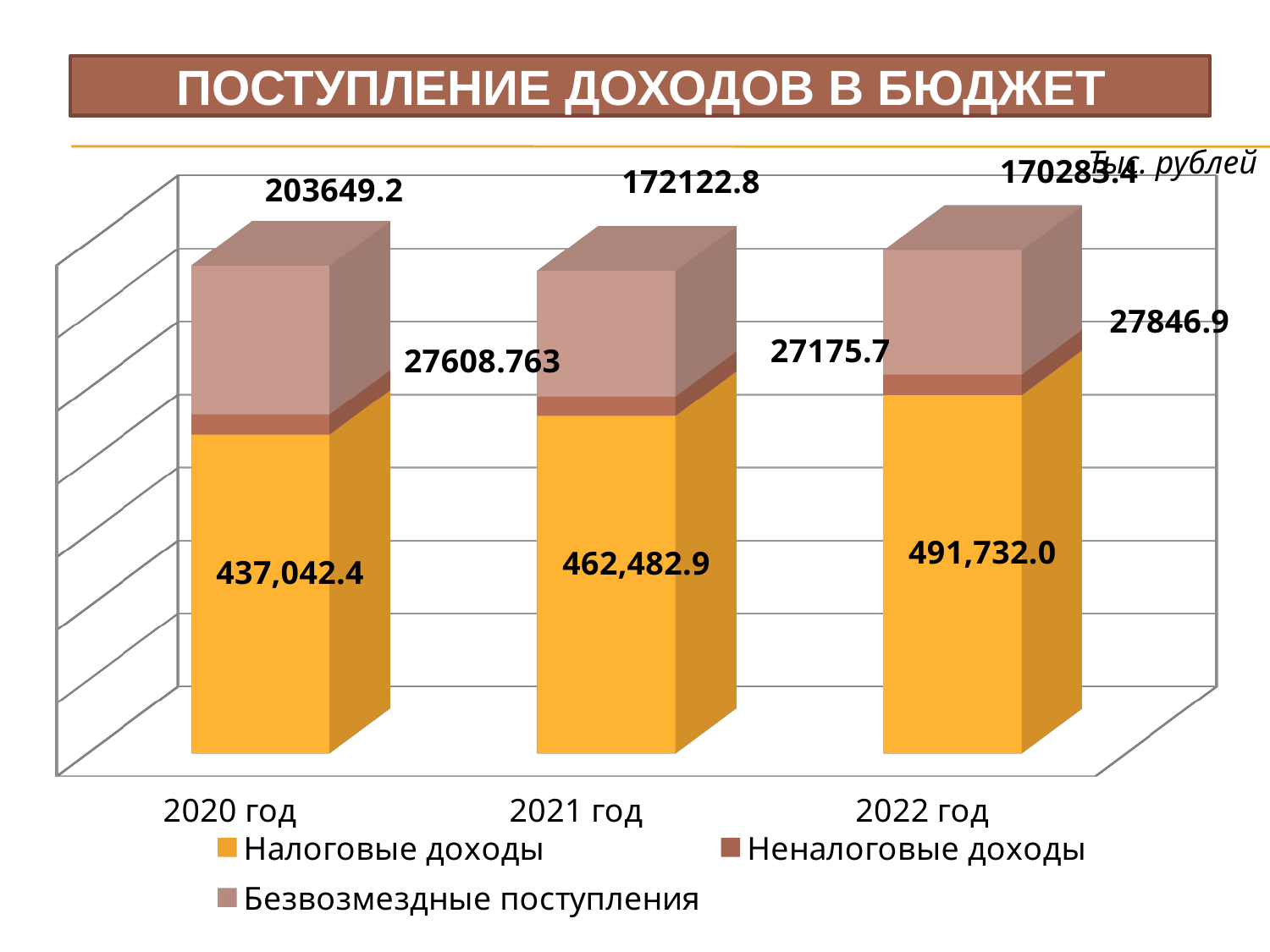
How many years (categories) are shown on the x axis of the chart? 3 What is the value of Безвозмездные поступления for 2020 год? 203649.2 What is the value of Налоговые доходы for 2022 год? 491,732.0 How many series does the chart legend list? 3 What is the value of Безвозмездные поступления for 2021 год? 172122.8 Which year has the larger value of Безвозмездные поступления, 2020 год or 2021 год? 2020 год Do the values of Налоговые доходы rise or fall from 2020 год to 2022 год? Rise What kind of chart is shown on the slide? Stacked bar chart What is the value of Налоговые доходы for 2021 год? 462,482.9 What is the value of Налоговые доходы for 2020 год? 437,042.4 In which year is the value of Налоговые доходы the highest? 2022 год What is the difference between Налоговые доходы in 2022 год and in 2021 год? 29,249.1